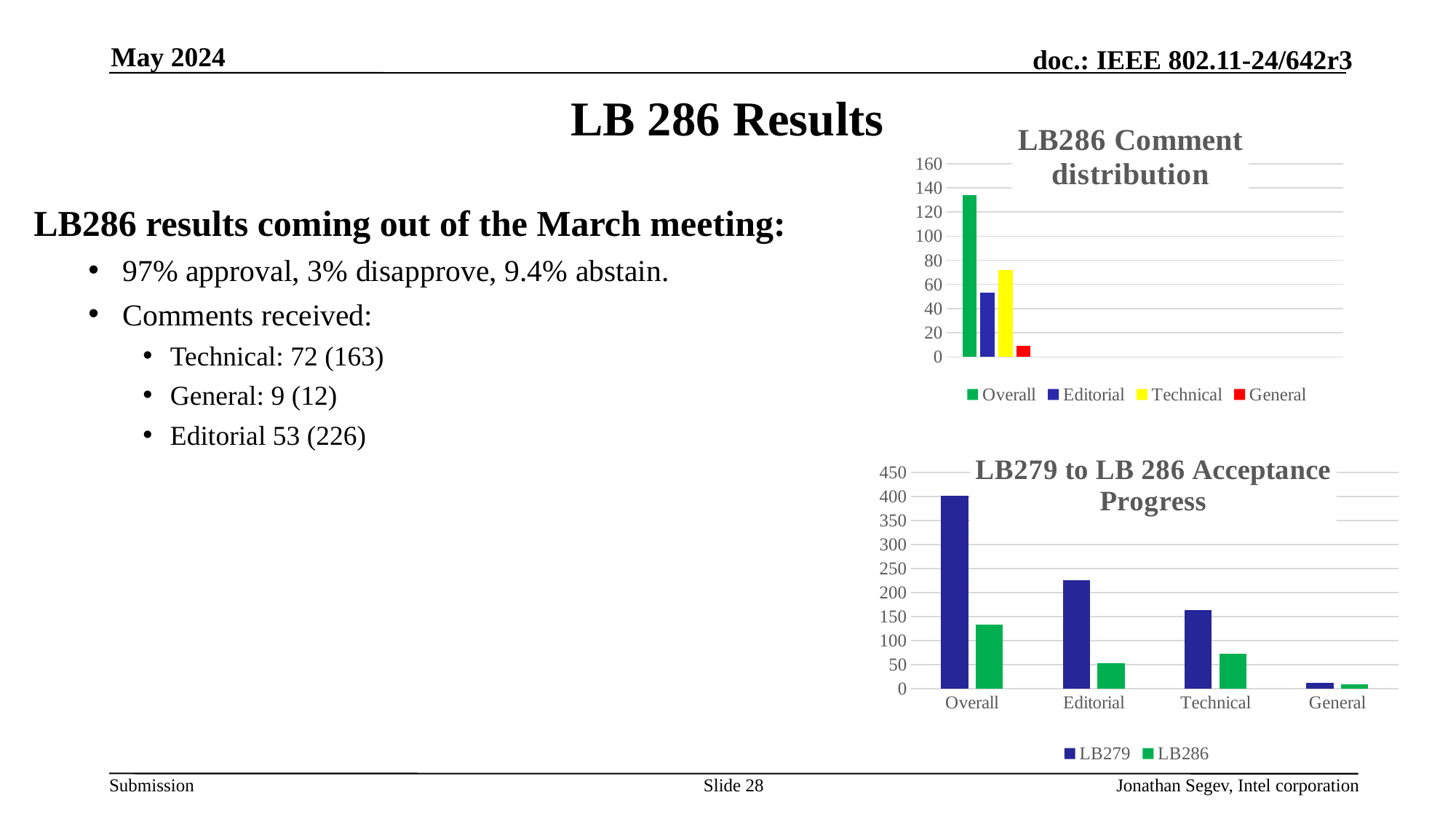
In the LB286 Comment distribution chart, how many series does the legend list? 4 In the LB286 Comment distribution chart, is the value for Editorial greater or less than 60? less In the LB286 Comment distribution chart, which series has the tallest bar? Overall In the LB279 to LB 286 Acceptance Progress chart, is the LB279 value for Overall greater or less than 350? greater What kind of chart is the LB279 to LB 286 Acceptance Progress chart? Bar chart In the LB279 to LB 286 Acceptance Progress chart, how many categories are shown on the x axis? 4 In the LB286 Comment distribution chart, what colour is the Technical bar? Yellow In the LB286 Comment distribution chart, which is larger, Technical or Editorial? Technical In the LB286 Comment distribution chart, which series has the shortest bar? General In the LB279 to LB 286 Acceptance Progress chart, which category has the highest LB279 value? Overall In the LB279 to LB 286 Acceptance Progress chart, which series does the legend list besides LB279? LB286 In the LB286 Comment distribution chart, is the value for Overall greater or less than 120? greater